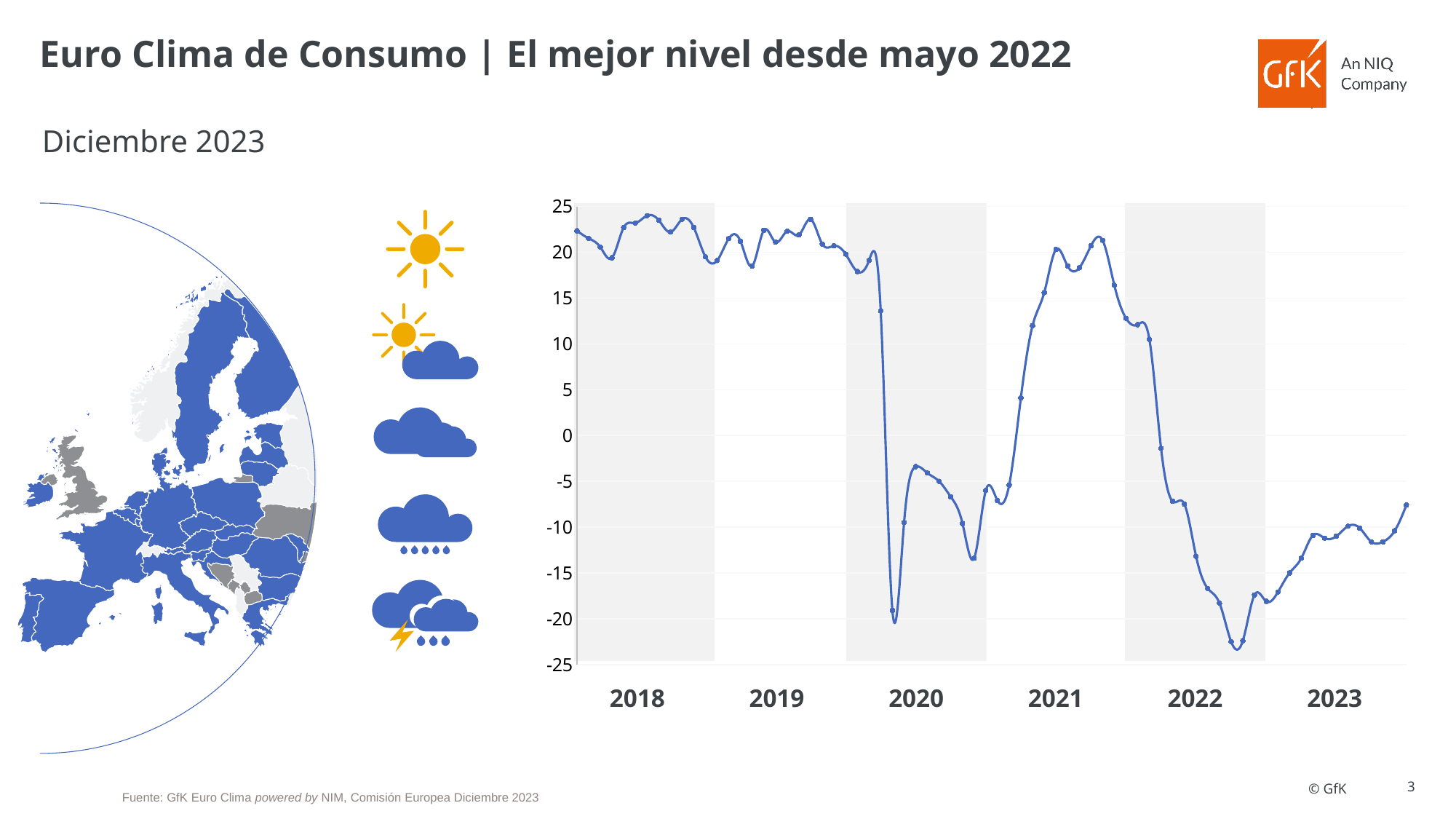
Does the line rise or fall from the low point in 2022 to the end of 2023? rise Is the value at the start of 2018 greater or less than 20? greater Is the lowest value reached in 2020 greater or less than -15? less Is the last value plotted at the end of 2023 greater or less than -10? greater What kind of chart is shown on the right of the slide? line chart Does the line rise or fall from the peak in 2021 to the low point in 2022? fall Which is the first year labelled on the x axis of the line chart? 2018 Which is higher, the value at the start of 2018 or the value at the end of 2023? start of 2018 How many years are labelled on the x axis of the line chart? 6 Which is lower, the minimum reached in 2020 or the minimum reached in 2022? 2022